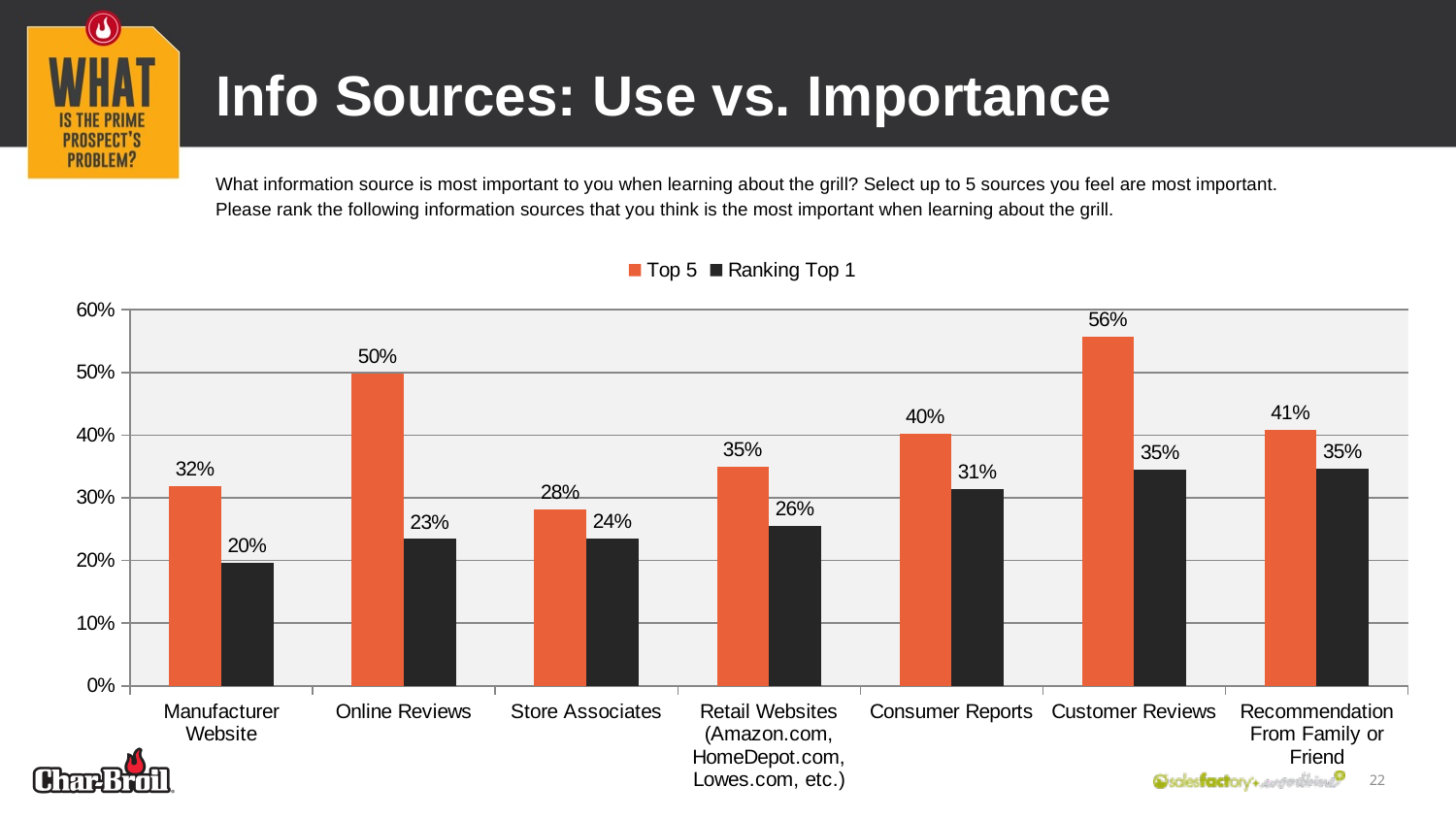
How many categories are shown on the x axis? 7 Which series is shown in orange? Top 5 Which is larger: the Top 5 value for Consumer Reports or the Top 5 value for Recommendation From Family or Friend? Recommendation From Family or Friend What is the Ranking Top 1 value for Manufacturer Website? 20% Which category has the lowest Ranking Top 1 value? Manufacturer Website What is the Top 5 value for Store Associates? 28% Is the Top 5 value for Retail Websites greater or less than 30%? greater Which category has the highest Top 5 value? Customer Reviews What is the Top 5 value for Customer Reviews? 56% What kind of chart is shown on the slide? Bar chart What is the difference between the Top 5 and Ranking Top 1 values for Online Reviews? 27% How many series does the legend list? 2